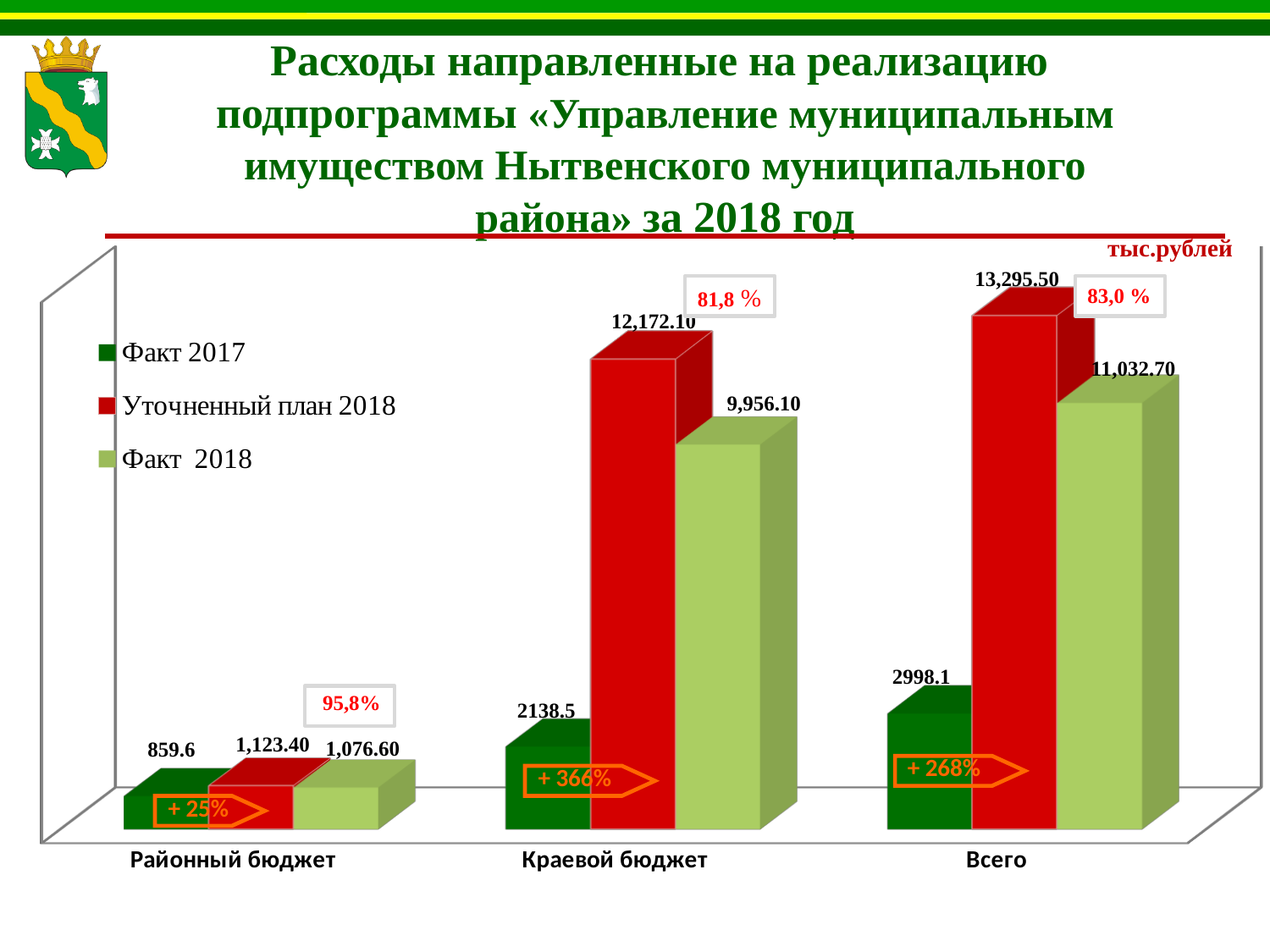
How many categories are shown on the x axis? 3 What is the value of Факт 2018 for Всего? 11,032.70 What is the value of Факт 2017 for Районный бюджет? 859.6 What is the difference between Уточненный план 2018 and Факт 2018 for Краевой бюджет? 2,216.00 What is the value of Уточненный план 2018 for Краевой бюджет? 12,172.10 Which category has the highest Уточненный план 2018 value? Всего What is the value of Факт 2017 for Всего? 2998.1 Which is larger for Районный бюджет: Уточненный план 2018 or Факт 2018? Уточненный план 2018 What kind of chart is shown on the slide? bar chart What unit of measurement is indicated in the top right corner of the chart? тыс.рублей Which category has the lowest Факт 2018 value? Районный бюджет How many series does the legend list? 3